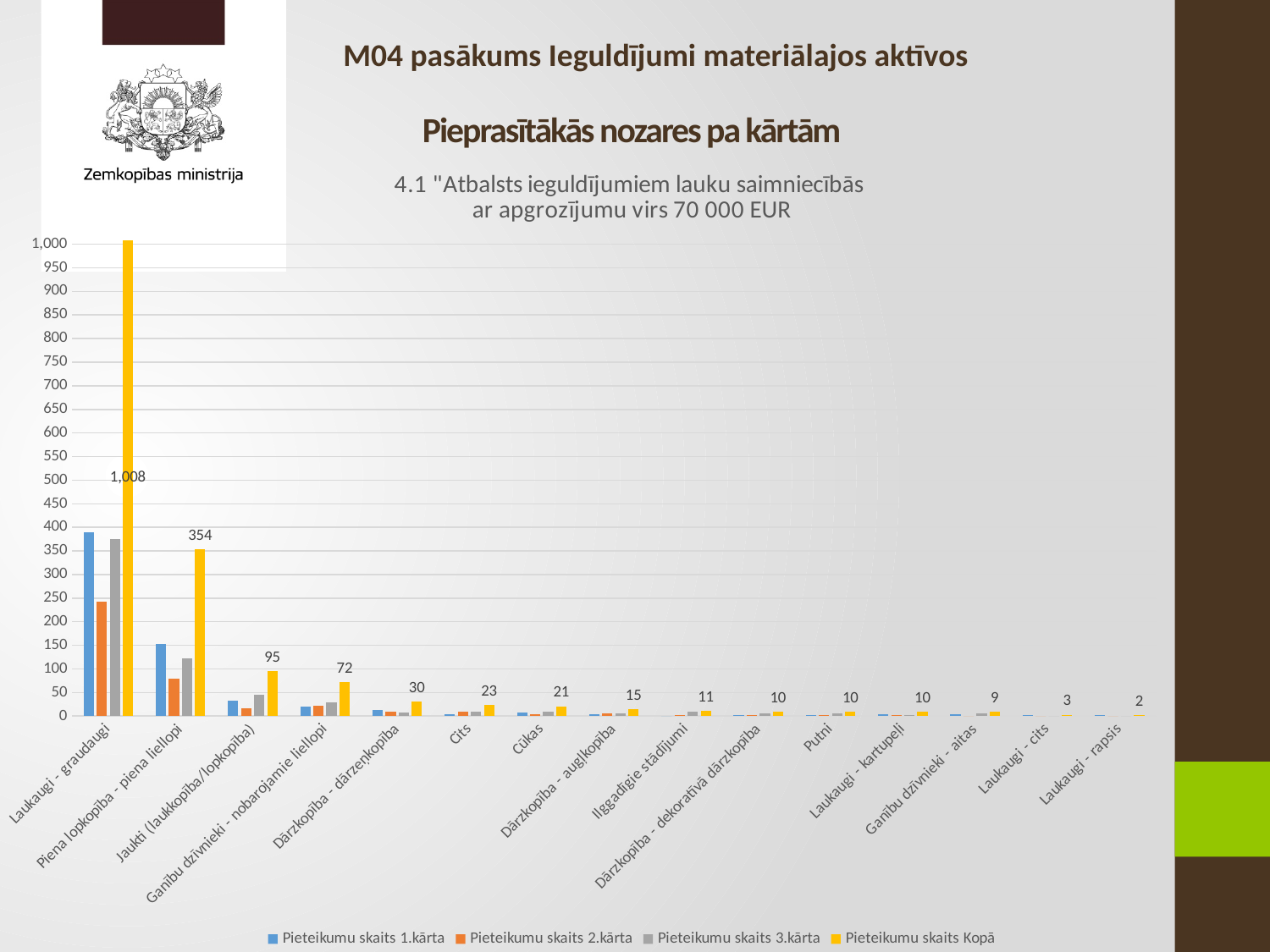
How many categories are shown on the x axis of the chart? 15 Which category has the lowest Pieteikumu skaits Kopā value? Laukaugi - rapsis Which category has the highest Pieteikumu skaits Kopā value? Laukaugi - graudaugi What is the value of Pieteikumu skaits Kopā for Laukaugi - graudaugi? 1,008 Is the value of Pieteikumu skaits 2.kārta for Laukaugi - graudaugi greater or less than 300? less What is the value of Pieteikumu skaits Kopā for Piena lopkopība - piena liellopi? 354 What is the value of Pieteikumu skaits Kopā for Cūkas? 21 How many series does the chart legend list? 4 Is the value of Pieteikumu skaits 1.kārta for Laukaugi - graudaugi greater or less than 350? greater Which has a larger Pieteikumu skaits Kopā value, Jaukti (laukkopība/lopkopība) or Ganību dzīvnieki - nobarojamie liellopi? Jaukti (laukkopība/lopkopība) What is the difference between the Pieteikumu skaits Kopā values for Laukaugi - graudaugi and Piena lopkopība - piena liellopi? 654 What kind of chart is shown on the slide? Bar chart